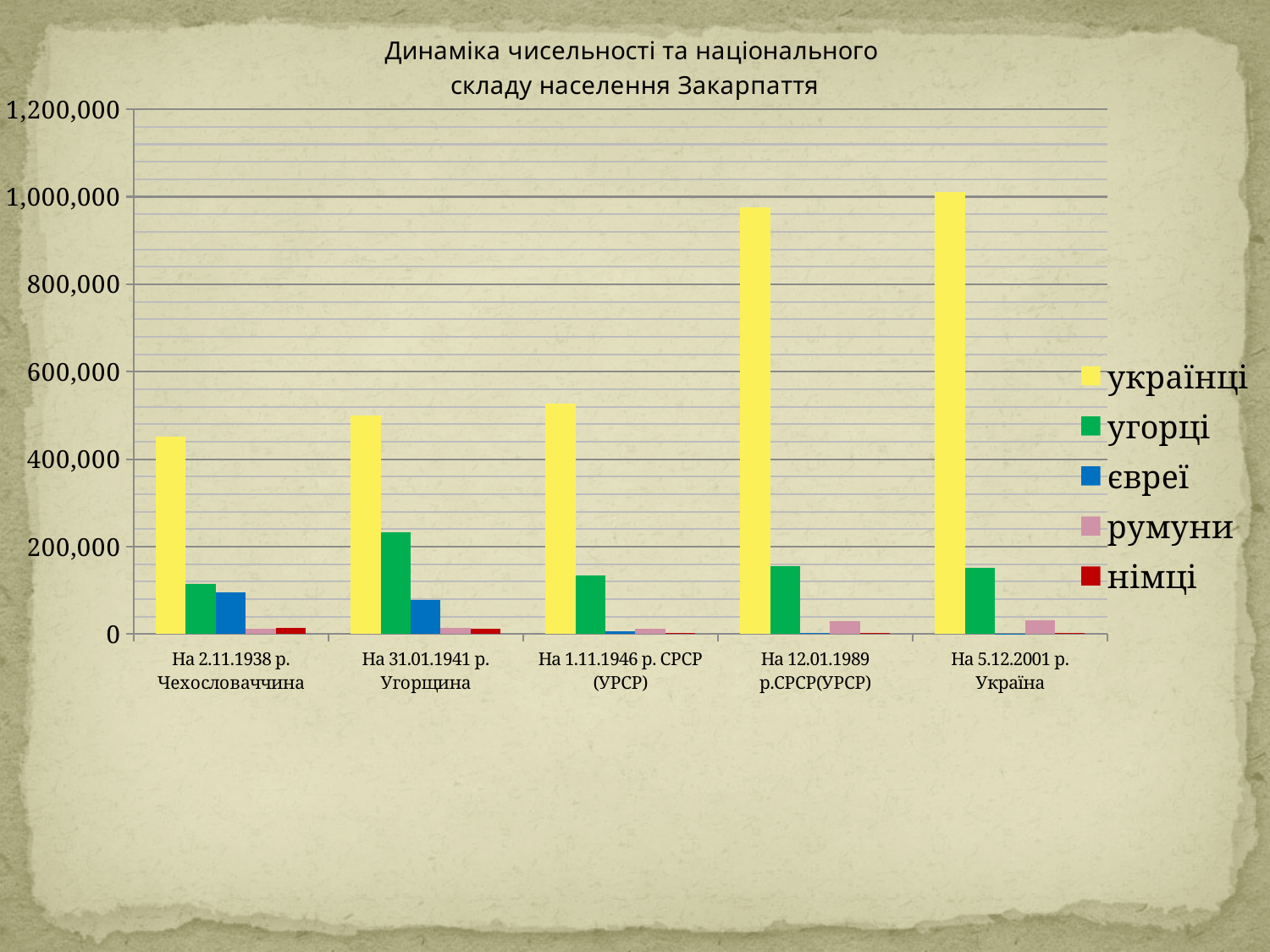
Is the value for угорці at На 31.01.1941 р. Угорщина greater or less than 200,000? greater In which category is the value for угорці the highest? На 31.01.1941 р. Угорщина In which category is the value for українці the lowest? На 2.11.1938 р. Чехословаччина Is the value for українці at На 12.01.1989 р.СРСР(УРСР) greater or less than 800,000? greater At На 2.11.1938 р. Чехословаччина, which is larger: угорці or євреї? угорці Is the value for українці at На 2.11.1938 р. Чехословаччина greater or less than 400,000? greater How many categories (dates) are shown along the x axis? 5 In which category is the value for українці the highest? На 5.12.2001 р. Україна Do the values for українці rise or fall from left to right along the x axis? rise How many series does the legend list? 5 What kind of chart is shown on the slide? bar chart